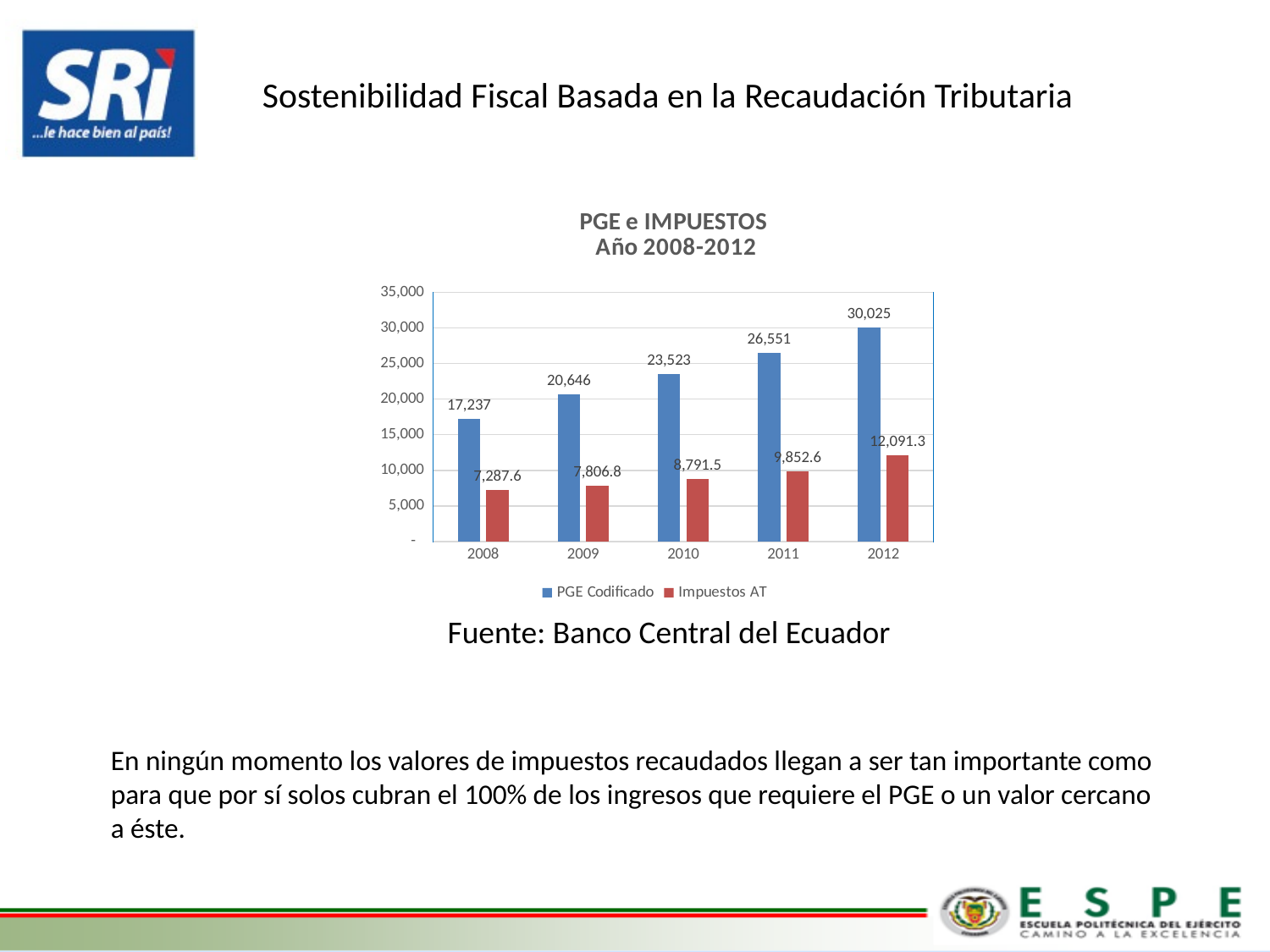
Do the PGE Codificado values rise or fall from 2008 to 2012? Rise Which year has the lowest Impuestos AT value? 2008 What is the difference between PGE Codificado in 2012 and in 2008? 12,788 What kind of chart is shown? Bar chart What is the value of Impuestos AT for 2011? 9,852.6 Which year has the highest PGE Codificado value? 2012 Is the Impuestos AT value for 2012 greater or less than 10,000? greater Which is larger in 2009: PGE Codificado or Impuestos AT? PGE Codificado What is the value of PGE Codificado for 2010? 23,523 How many years are shown on the x axis? 5 How many series does the legend list? 2 What is the value of Impuestos AT for 2008? 7,287.6